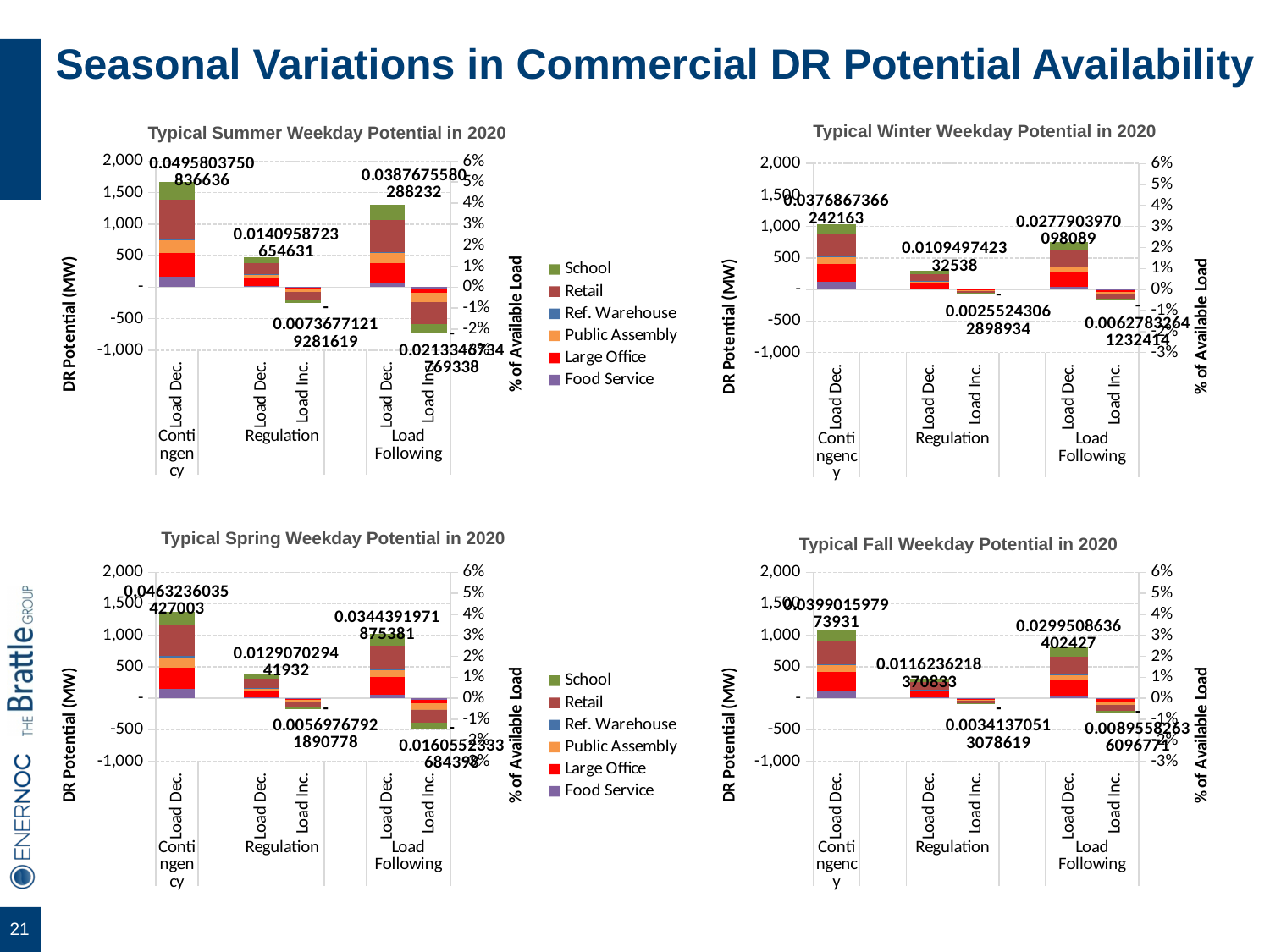
How many bars are plotted in the 'Typical Spring Weekday Potential in 2020' chart? 5 In the 'Typical Winter Weekday Potential in 2020' chart, is the total of the Contingency Load Dec. bar greater or less than 500? greater Which series is listed first in the legend of the 'Typical Spring Weekday Potential in 2020' chart? School In the 'Typical Fall Weekday Potential in 2020' chart, which bar is the tallest? Contingency Load Dec. In the 'Typical Summer Weekday Potential in 2020' chart, which is larger: the Contingency Load Dec. bar or the Load Following Load Dec. bar? Contingency Load Dec. What kind of chart is the 'Typical Summer Weekday Potential in 2020' chart? bar chart What data label is printed above the Load Following Load Dec. bar in the 'Typical Spring Weekday Potential in 2020' chart? 0.0344391971875381 What data label is printed above the Contingency Load Dec. bar in the 'Typical Winter Weekday Potential in 2020' chart? 0.0376867366242163 In the 'Typical Summer Weekday Potential in 2020' chart, is the Load Following Load Inc. bar greater or less than -500? less What is the label of the right-hand vertical axis on the 'Typical Fall Weekday Potential in 2020' chart? % of Available Load In the 'Typical Summer Weekday Potential in 2020' chart, is the total of the Contingency Load Dec. bar greater or less than 1,500? greater